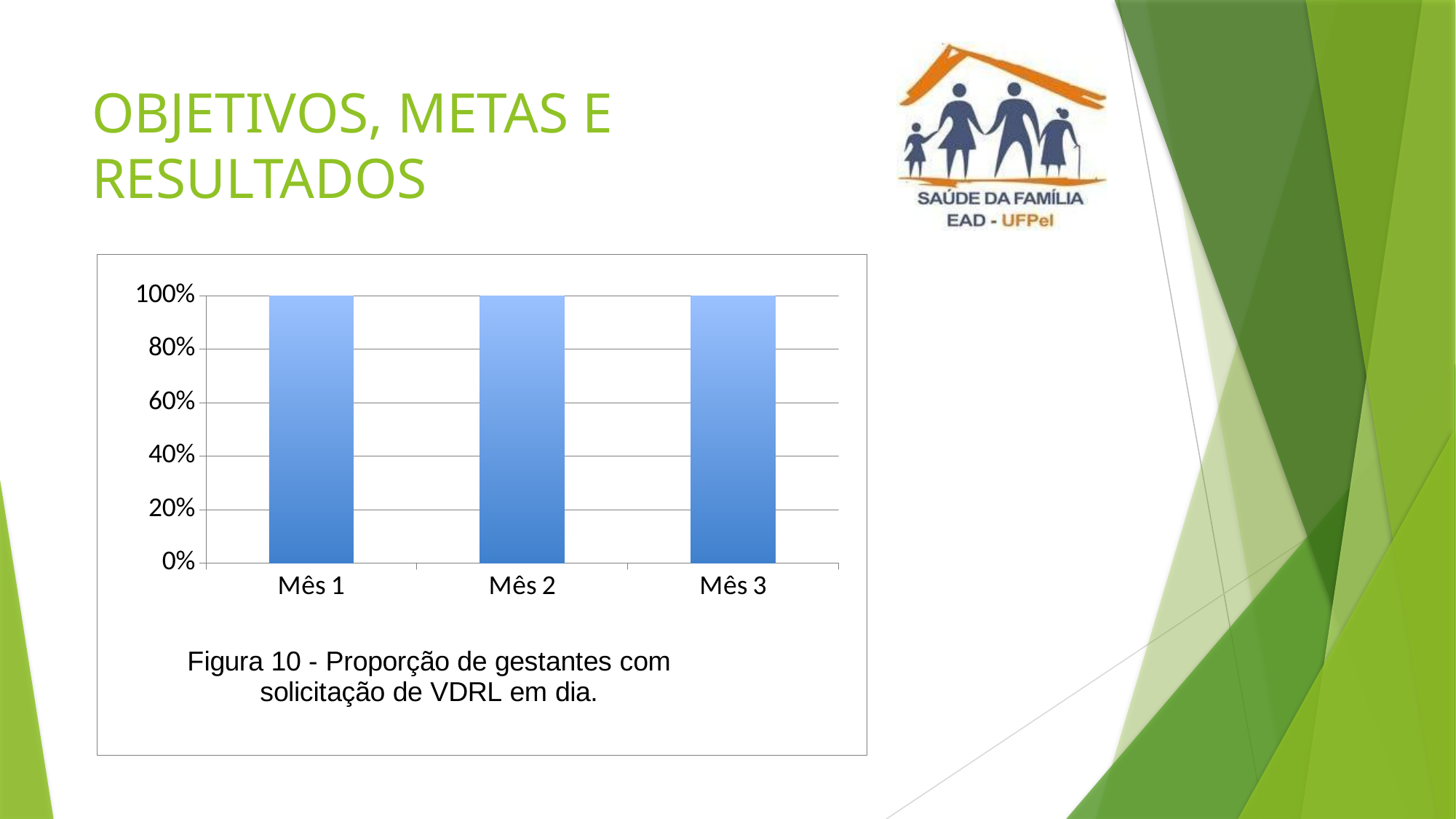
Is the value for Mês 3 greater or less than 60%? greater How many categories (months) are shown on the x axis of the chart? 3 What is the value for Mês 1 in the chart? 100% What is the difference between the values for Mês 1 and Mês 3? 0% What is the highest value shown on the y axis of the chart? 100% Do the values rise, fall, or stay the same from Mês 1 to Mês 3? stay the same What is the value for Mês 2 in the chart? 100% Is the value for Mês 2 greater or less than 80%? greater What is the value for Mês 3 in the chart? 100% What type of chart is shown on the slide? bar chart What is the caption (figure title) given below the chart? Figura 10 - Proporção de gestantes com solicitação de VDRL em dia.